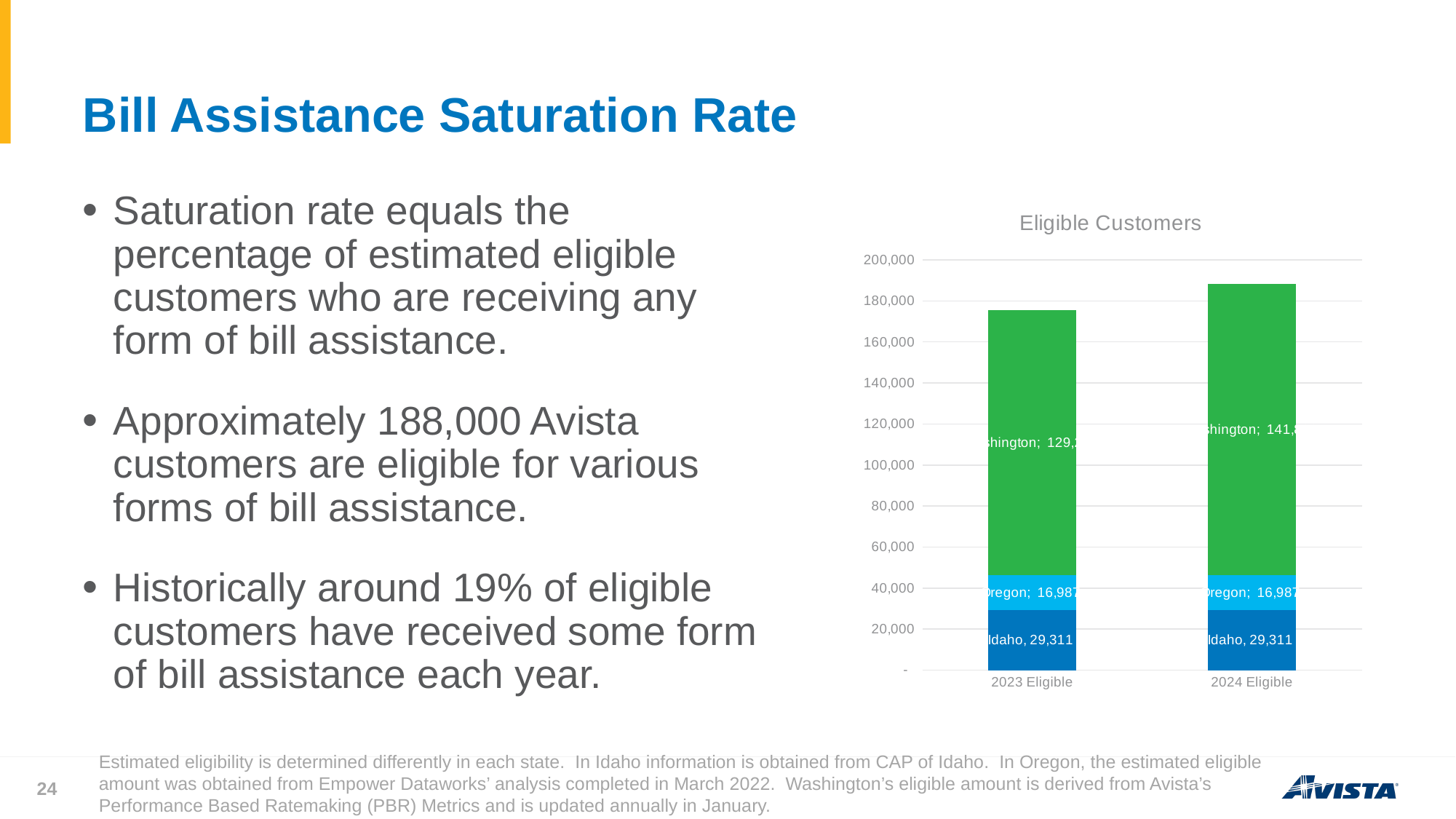
What is the Idaho value in the 2023 Eligible bar? 29,311 What is the difference between the Idaho and Oregon values in the 2023 Eligible bar? 12,324 Does the total number of eligible customers rise or fall from 2023 to 2024? Rise Which state makes up the largest segment of each bar? Washington How many bars (categories) are plotted in the chart? 2 What is the Idaho value in the 2024 Eligible bar? 29,311 Which bar is taller overall, 2023 Eligible or 2024 Eligible? 2024 Eligible What kind of chart is shown on the slide? Stacked bar chart What is the Oregon value in the 2024 Eligible bar? 16,987 What is the title of the chart? Eligible Customers Is the total of the 2024 Eligible bar greater or less than 180,000? greater Is the total of the 2023 Eligible bar greater or less than 180,000? less